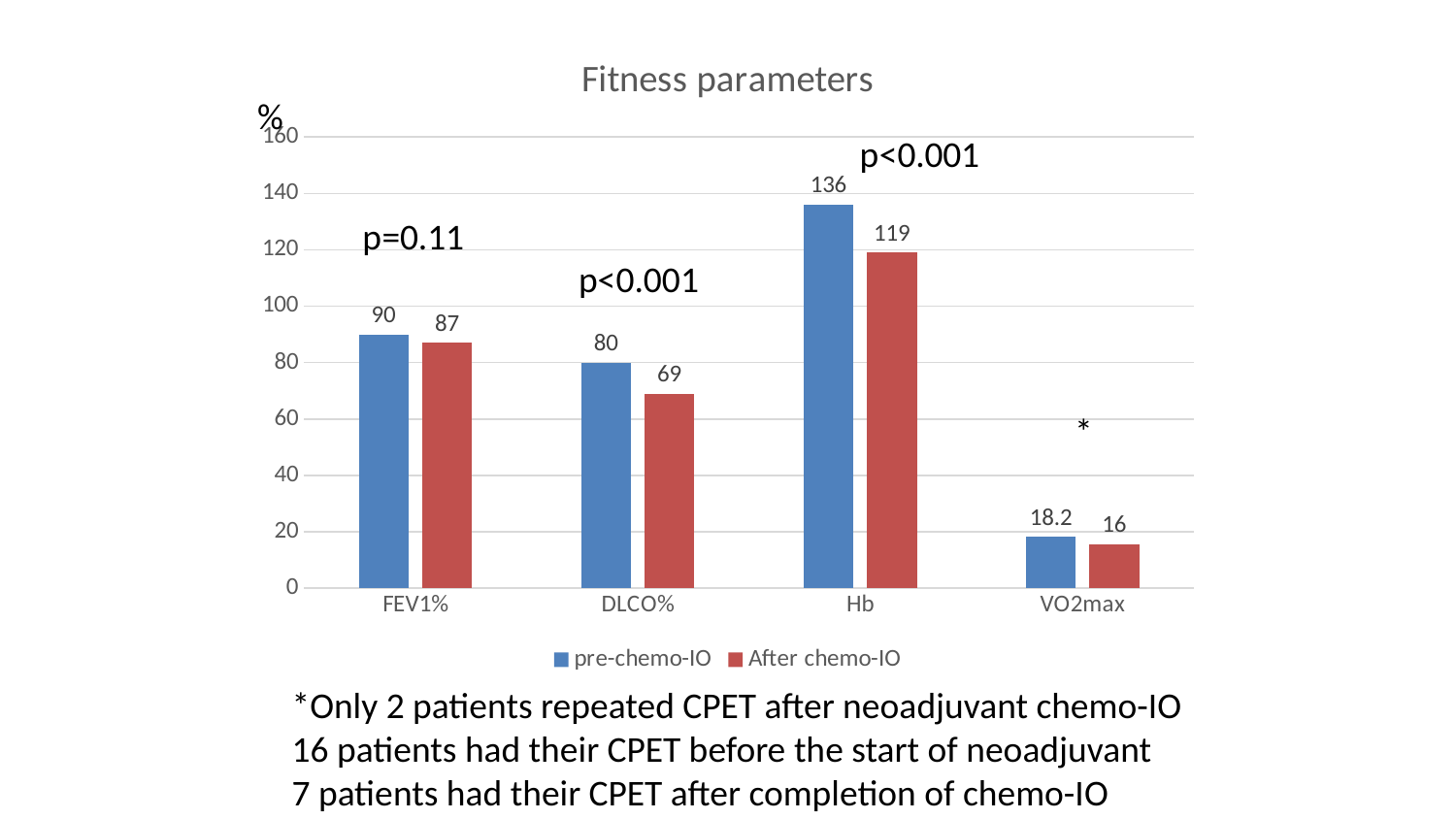
What is the After chemo-IO value for DLCO%? 69 What is the title of the chart? Fitness parameters What is the After chemo-IO value for Hb? 119 Which category has the highest pre-chemo-IO value? Hb What is the difference between the pre-chemo-IO and After chemo-IO values for Hb? 17 Which is larger for DLCO%: the pre-chemo-IO value or the After chemo-IO value? pre-chemo-IO What is the pre-chemo-IO value for FEV1%? 90 What is the pre-chemo-IO value for VO2max? 18.2 How many categories are shown on the x axis? 4 Which category has the lowest After chemo-IO value? VO2max What kind of chart is shown on the slide? Bar chart How many series does the legend list? 2